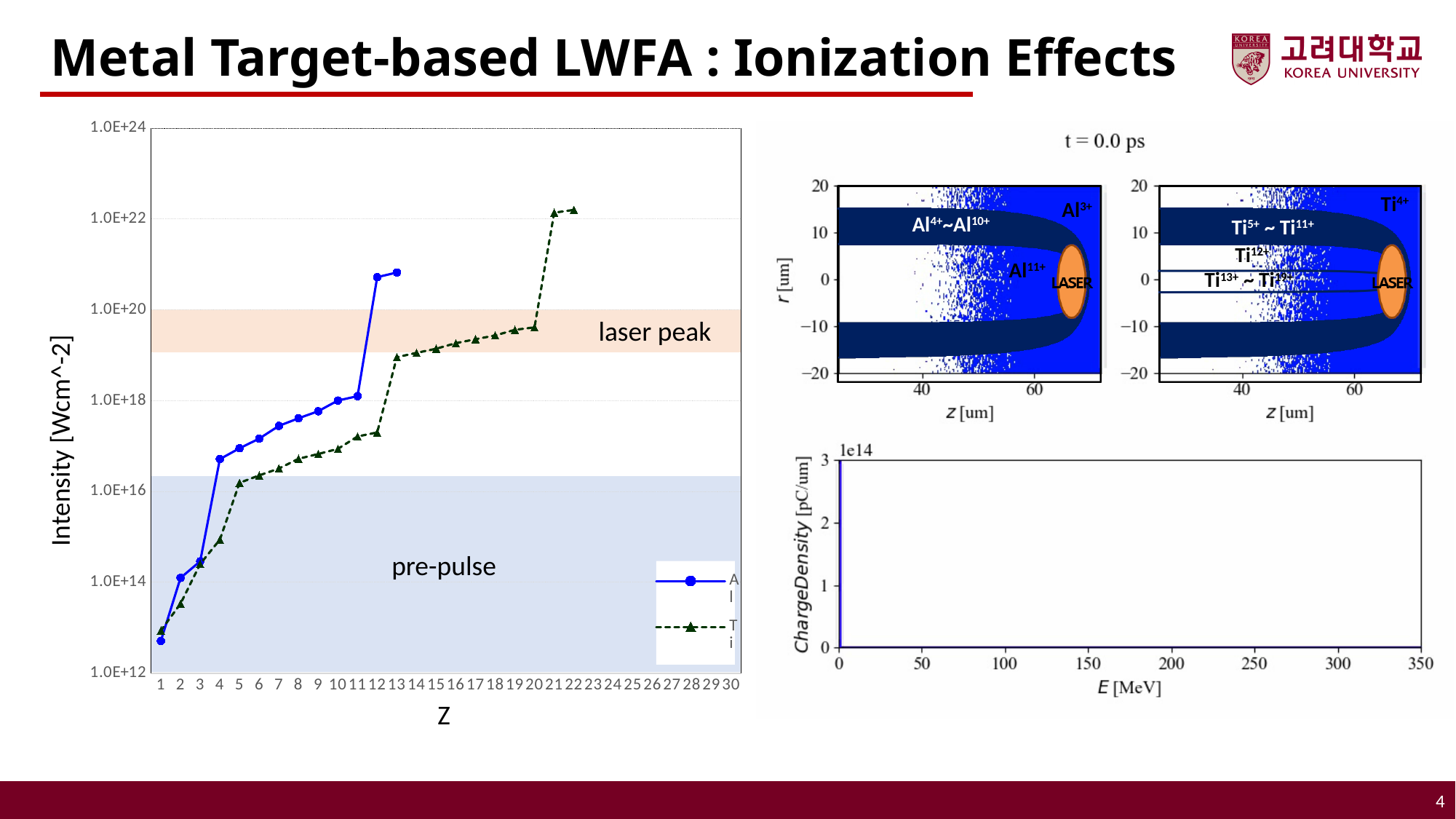
In the Intensity vs Z chart, is the Ti value at Z = 10 greater or less than 1.0E+18? less What are the labels of the two shaded horizontal bands in the Intensity vs Z chart? laser peak and pre-pulse What kind of chart is shown on the left of the slide? line chart In the Intensity vs Z chart, which series reaches the higher maximum intensity, Al or Ti? Ti What are the two series named in the legend of the Intensity vs Z chart? Al and Ti In the Intensity vs Z chart, do the intensity values rise or fall as Z increases? rise In the Intensity vs Z chart, how many data points does the Al series have? 13 In the Intensity vs Z chart, how many data points does the Ti series have? 22 In the Intensity vs Z chart, is the Al value at Z = 13 greater or less than 1.0E+20? greater How many series does the legend of the Intensity vs Z chart list? 2 In the Intensity vs Z chart, at Z = 4, which series has the larger intensity, Al or Ti? Al In the Intensity vs Z chart, is the Al value at Z = 1 greater or less than 1.0E+14? less